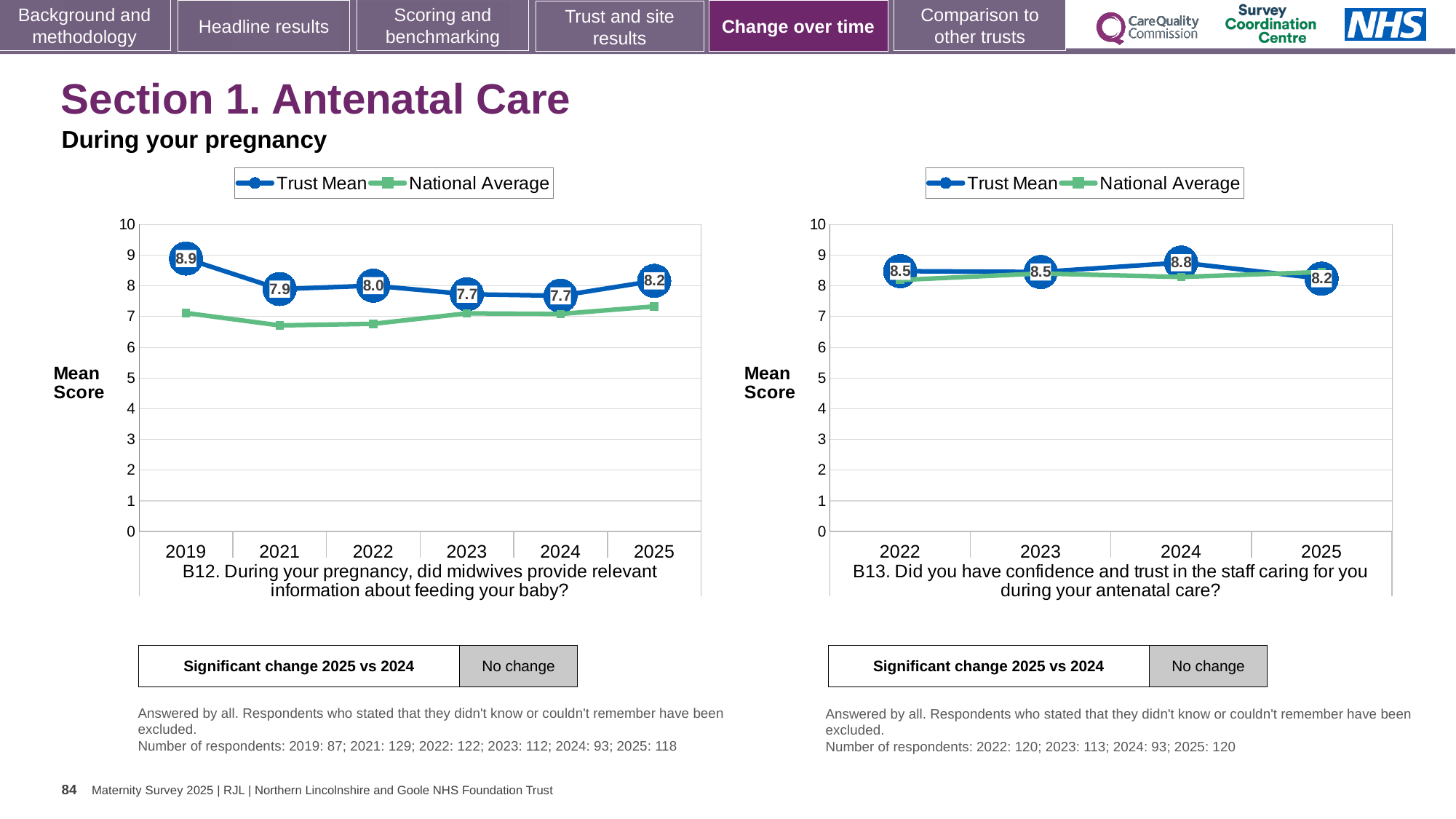
In the left chart (B12), what is the difference between the Trust Mean scores for 2019 and 2021? 1.0 How many series does the legend of the left chart (B12) list? 2 In the left chart (B12), what is the Trust Mean score for 2019? 8.9 In the left chart (B12), which year has the highest Trust Mean score? 2019 What type of chart is the right chart (B13)? Line chart In the right chart (B13), which year has the lowest Trust Mean score? 2025 How many years are shown on the x axis of the right chart (B13)? 4 In the left chart (B12), is the National Average value for 2021 greater or less than 7? less In the left chart (B12), is the Trust Mean score higher in 2022 or in 2023? 2022 In the right chart (B13), what is the difference between the Trust Mean scores for 2024 and 2025? 0.6 In the left chart (B12), what is the Trust Mean score for 2025? 8.2 In the right chart (B13), what is the Trust Mean score for 2024? 8.8